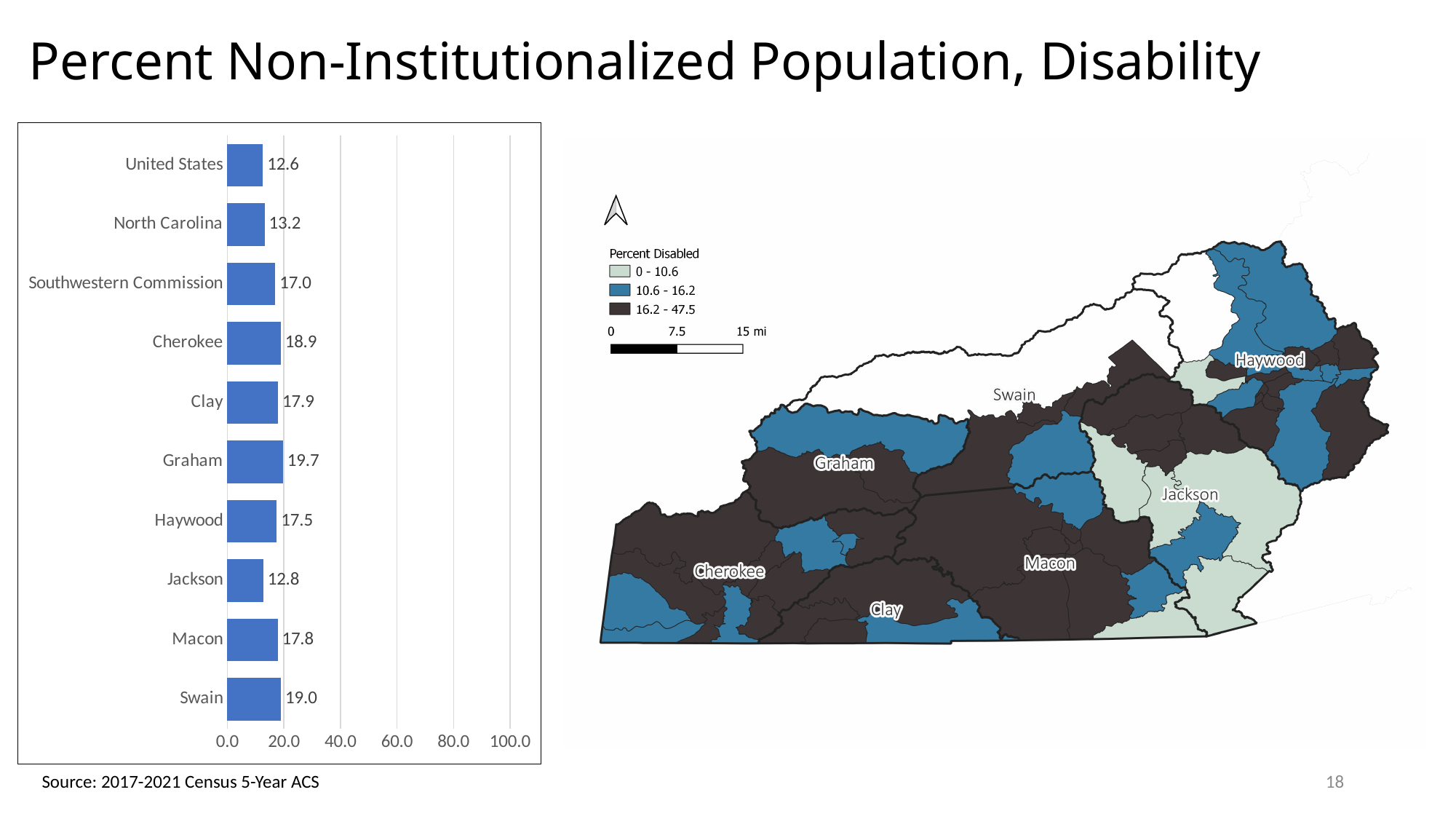
What is the value for Southwestern Commission in the bar chart? 17.0 What is the highest value shown on the x axis of the bar chart? 100.0 What is the value for Cherokee in the bar chart? 18.9 What is the difference between the values for Graham and Jackson in the bar chart? 6.9 Which category has the lowest value in the bar chart? United States Which category has the highest value in the bar chart? Graham What is the range of the darkest category in the map legend? 16.2 - 47.5 What kind of chart is shown on the left of the slide? bar chart Is the value for Clay in the bar chart greater or less than 20.0? less Which is larger in the bar chart, the value for Swain or the value for Macon? Swain How many categories are shown in the bar chart? 10 What is the value for North Carolina in the bar chart? 13.2